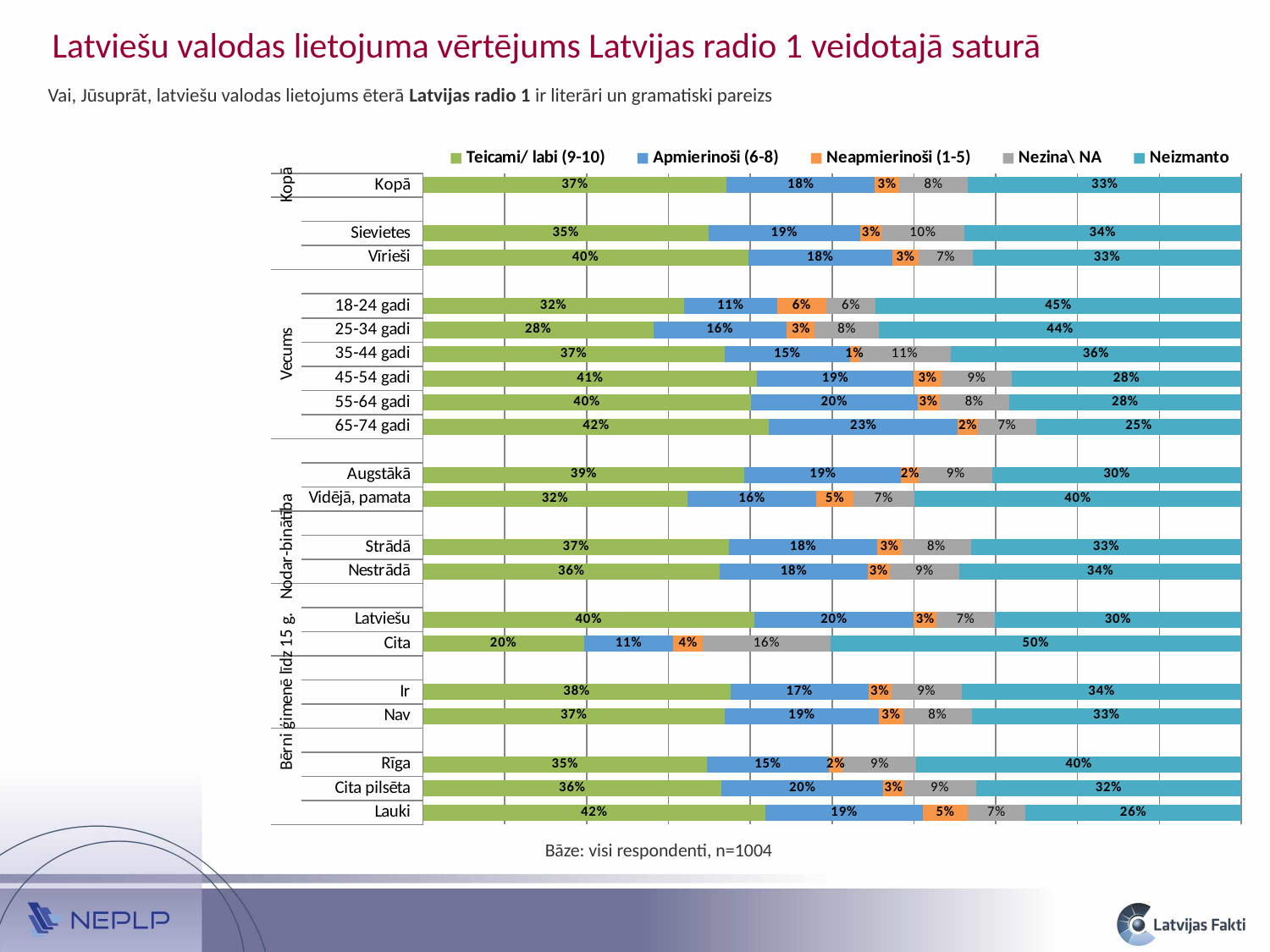
How many categories (rows) are plotted in the chart? 20 Which category has the highest Neizmanto value? Cita How many series does the legend list? 5 What is the value of Neizmanto for 18-24 gadi? 45% What kind of chart is shown on the slide? Stacked bar chart What is the value of Apmierinoši (6-8) for 65-74 gadi? 23% What is the base stated below the chart? Bāze: visi respondenti, n=1004 Which category has the lowest Teicami/ labi (9-10) value? Cita Which has a larger Neizmanto value, Sievietes or Vīrieši? Sievietes What is the value of Teicami/ labi (9-10) for Kopā? 37% What is the value of Nezina\ NA for Cita? 16% What is the difference between the Teicami/ labi (9-10) values for Lauki and Rīga? 7%